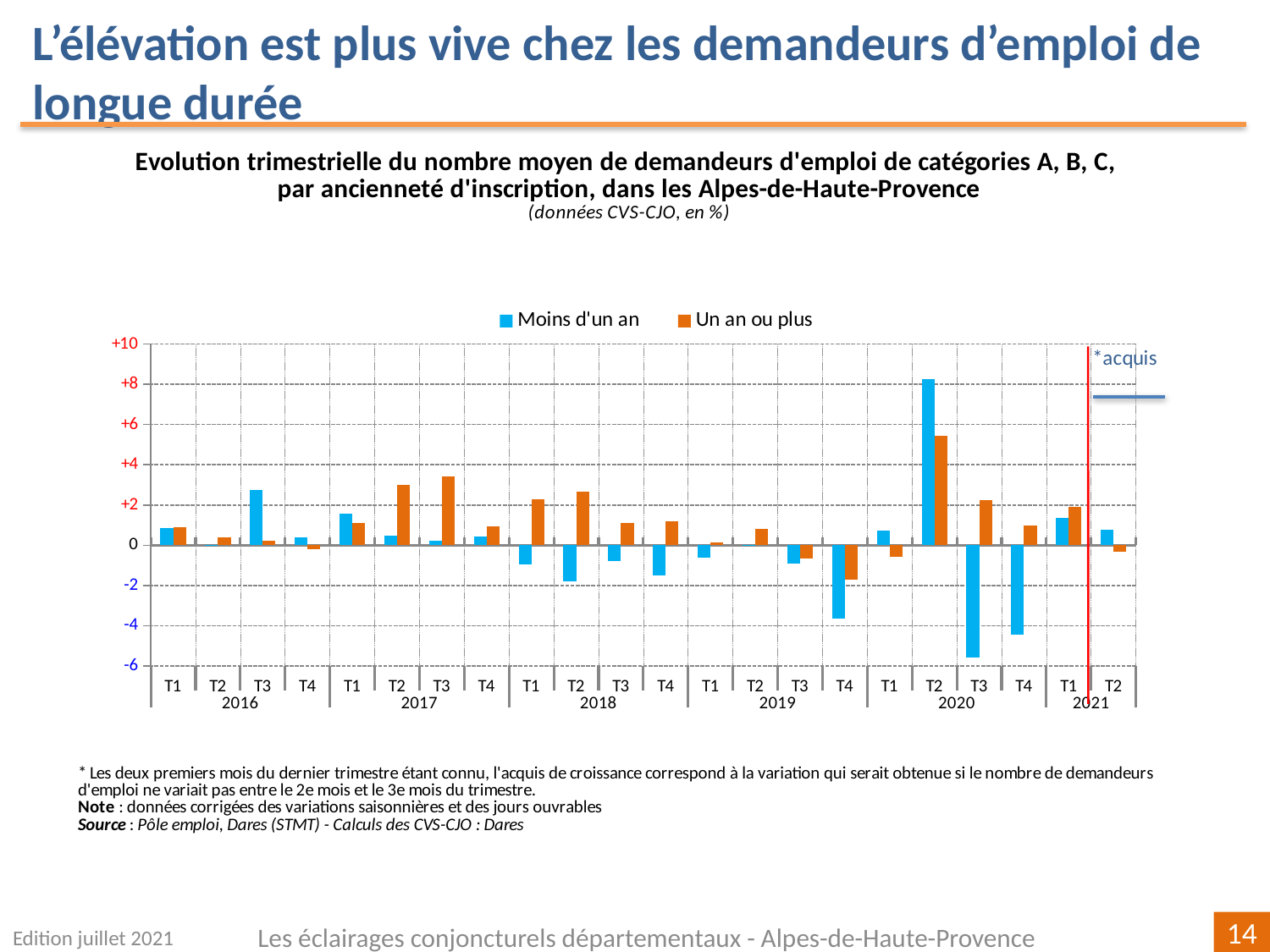
In which quarter is the value for 'Moins d'un an' highest? T2 2020 In which quarter is the value for 'Un an ou plus' lowest? T4 2019 In T2 2018, which series has the larger value, 'Moins d'un an' or 'Un an ou plus'? Un an ou plus What kind of chart is shown on the slide? bar chart Is the value for 'Un an ou plus' in T3 2017 greater or less than +2? greater Which colour represents the 'Un an ou plus' series? orange Is the value for 'Moins d'un an' in T3 2020 greater or less than -4? less In which quarter is the value for 'Moins d'un an' lowest? T3 2020 How many quarters are plotted along the x axis? 22 In which quarter is the value for 'Un an ou plus' highest? T2 2020 How many series does the legend list? 2 Is the value for 'Moins d'un an' in T2 2020 greater or less than +8? greater